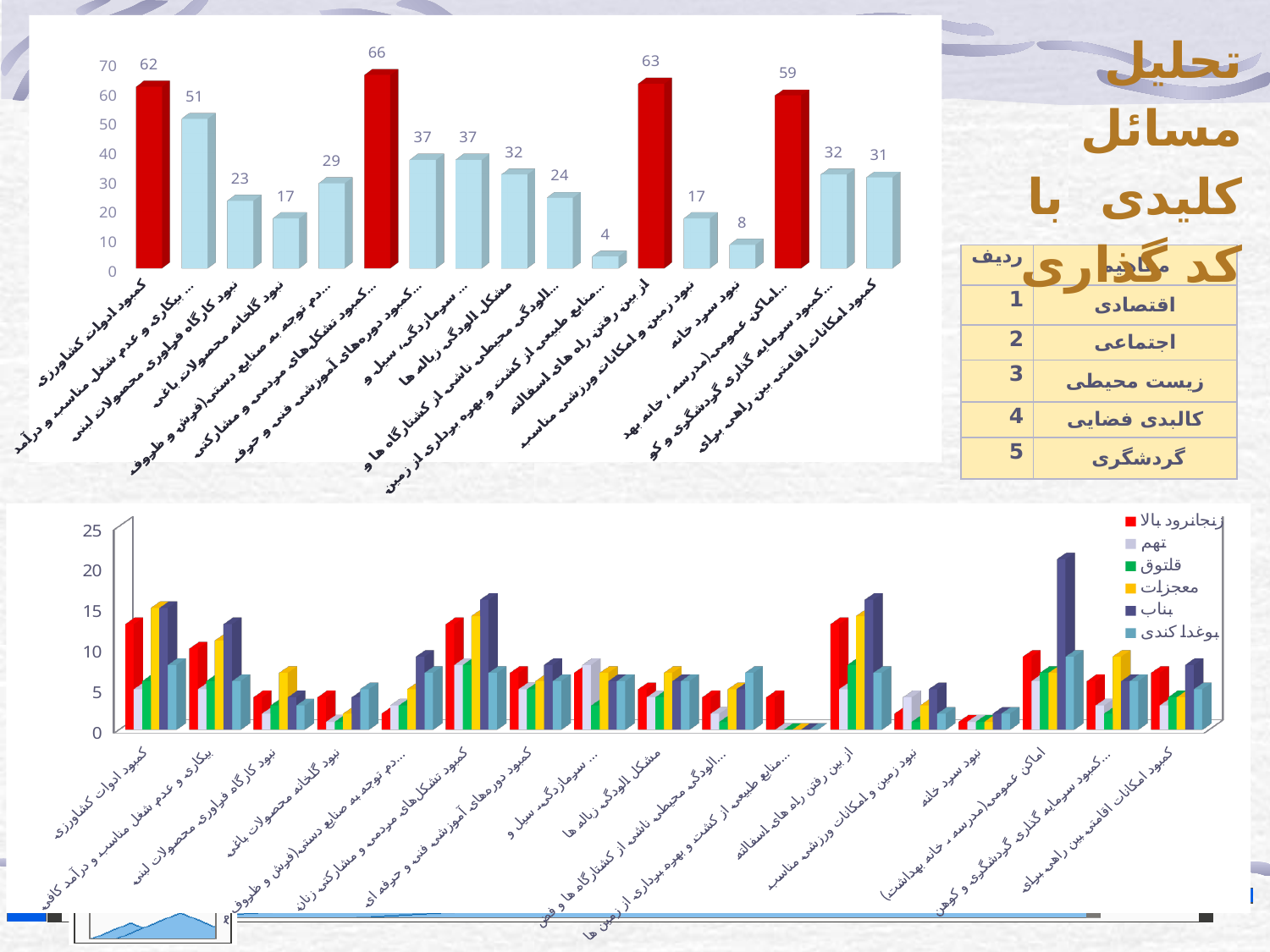
In the top chart, what is the lowest value shown on any bar? 4 How many bars are plotted in the top chart? 17 In the bottom chart, is the value of the بناب series for اماکن عمومی (مدرسه، خانه بهداشت) greater or less than 20? greater In the top chart, what is the value for نبود سرد خانه? 8 How many series does the legend of the bottom chart list? 6 In the top chart, what is the value for کمبود ادوات کشاورزی? 62 What type of chart is the top chart on the slide? bar chart In the top chart, what is the value for از بین رفتن راه های آسفالته? 63 In the top chart, how many bars are coloured red? 4 In the top chart, what is the difference between the value for کمبود ادوات کشاورزی (62) and the value for بیکاری و عدم شغل مناسب و درآمد کافی (51)? 11 In the top chart, which category has the highest value? کمبود تشکل های مردمی و مشارکتی (66)